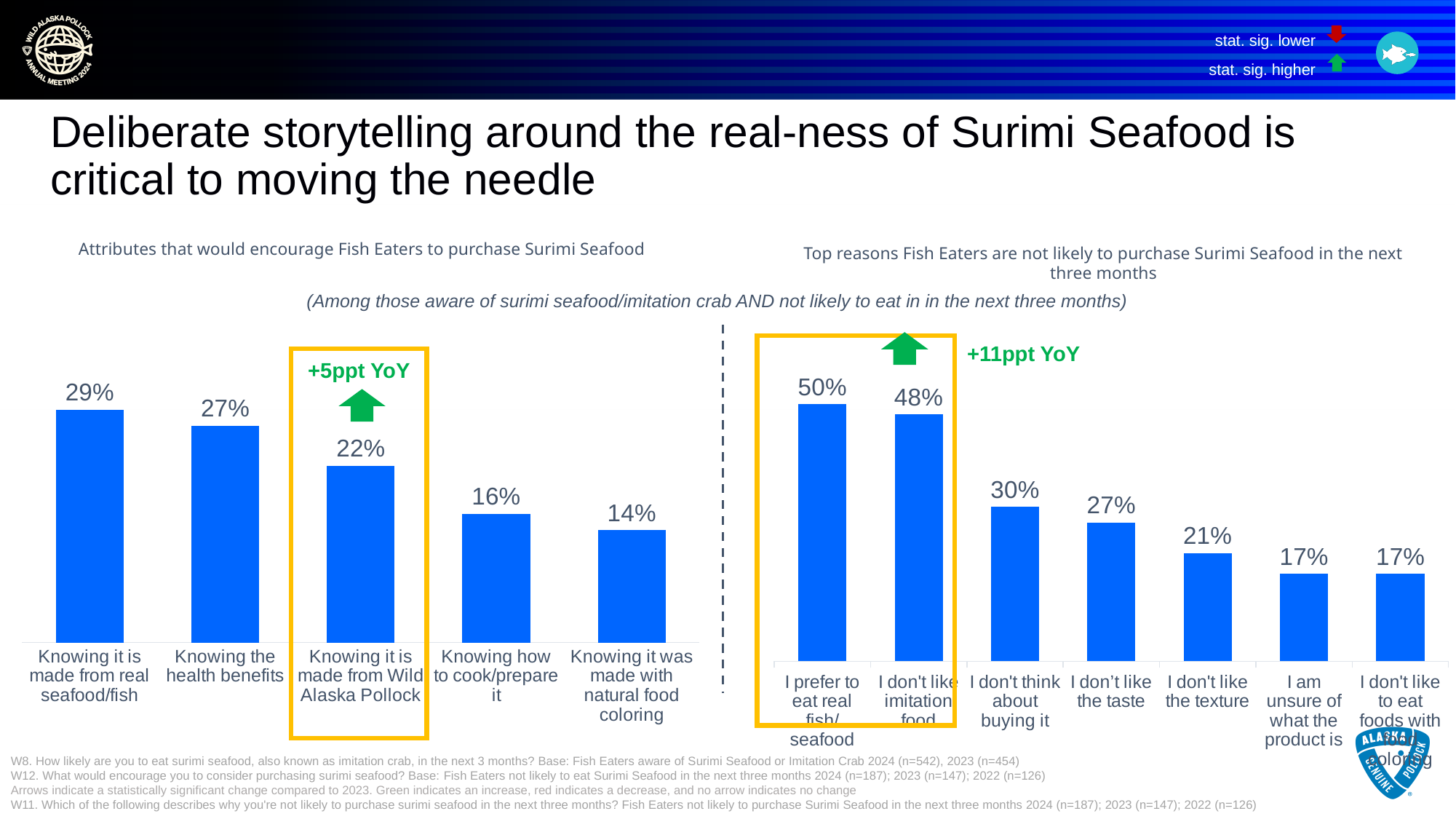
How many reasons are shown in the chart 'Top reasons Fish Eaters are not likely to purchase Surimi Seafood in the next three months'? 7 In the chart 'Attributes that would encourage Fish Eaters to purchase Surimi Seafood', which attribute has the lowest value? Knowing it was made with natural food coloring In the chart 'Top reasons Fish Eaters are not likely to purchase Surimi Seafood in the next three months', what is the value for 'I don't like the texture'? 21% In the chart 'Attributes that would encourage Fish Eaters to purchase Surimi Seafood', what is the value for 'Knowing it is made from Wild Alaska Pollock'? 22% In the chart 'Attributes that would encourage Fish Eaters to purchase Surimi Seafood', what is the value for 'Knowing it is made from real seafood/fish'? 29% In the chart 'Top reasons Fish Eaters are not likely to purchase Surimi Seafood in the next three months', what is the value for 'I prefer to eat real fish/seafood'? 50% In the chart 'Top reasons Fish Eaters are not likely to purchase Surimi Seafood in the next three months', what is the difference between 'I don't like imitation food' and 'I am unsure of what the product is'? 31 percentage points How many attributes are shown in the chart 'Attributes that would encourage Fish Eaters to purchase Surimi Seafood'? 5 In the chart 'Top reasons Fish Eaters are not likely to purchase Surimi Seafood in the next three months', which reason has the highest value? I prefer to eat real fish/seafood In the chart 'Attributes that would encourage Fish Eaters to purchase Surimi Seafood', what is the difference between 'Knowing the health benefits' and 'Knowing how to cook/prepare it'? 11 percentage points What type of chart is the chart on the left of the slide? Bar chart In the chart 'Top reasons Fish Eaters are not likely to purchase Surimi Seafood in the next three months', which is larger: 'I don't think about buying it' or 'I don't like the taste'? I don't think about buying it